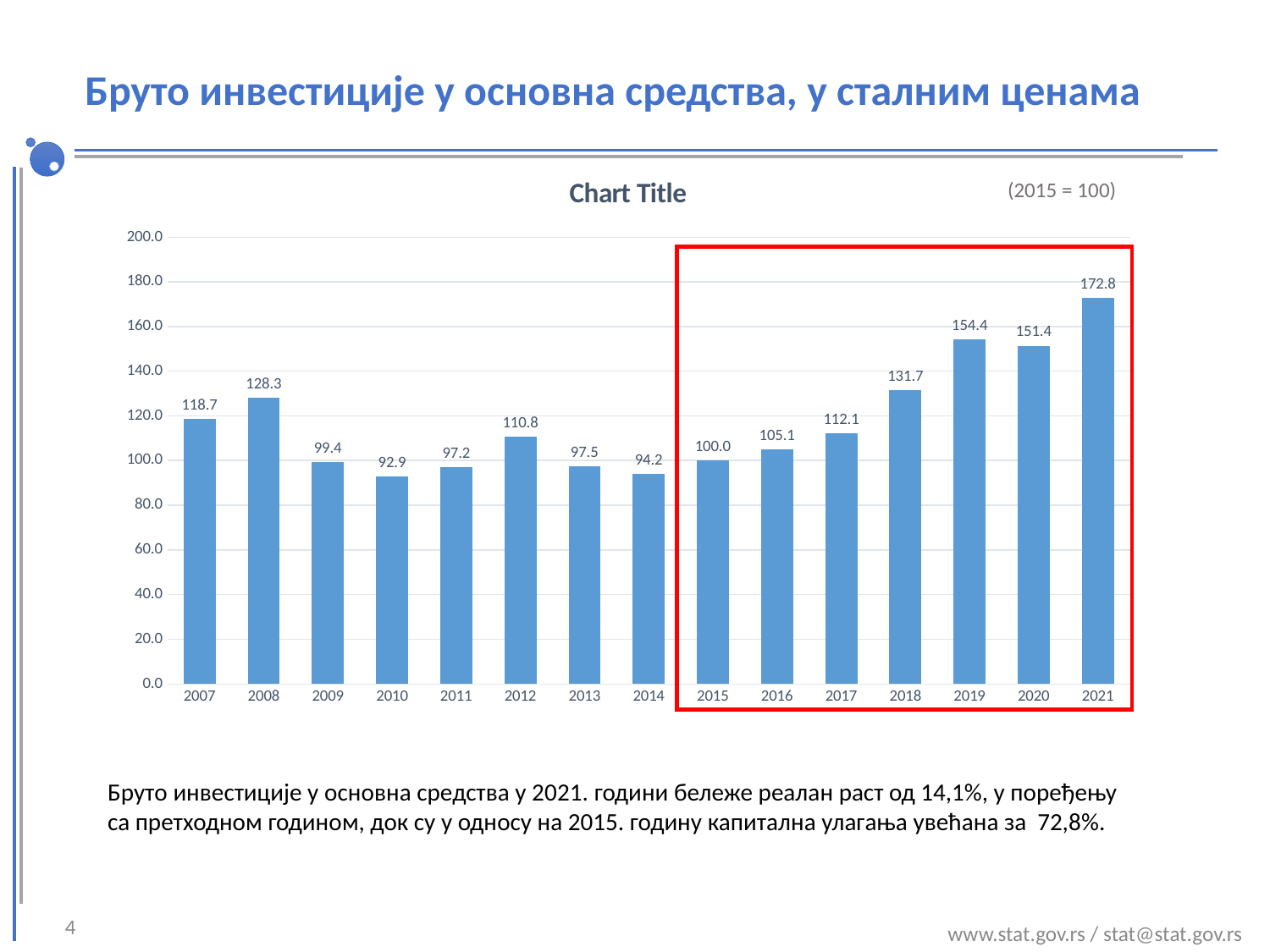
Is the value for 2018 greater or less than 120.0? greater Do the values rise or fall from 2015 to 2021? rise How many years are shown on the x axis? 15 What kind of chart is shown? bar chart Which is larger, the value for 2019 or the value for 2020? 2019 What base year is indicated in the note next to the chart title? 2015 = 100 What is the value for 2015? 100.0 Which year has the highest value? 2021 What is the value for 2010? 92.9 What is the value for 2021? 172.8 Which year has the lowest value? 2010 What is the difference between the values for 2021 and 2020? 21.4